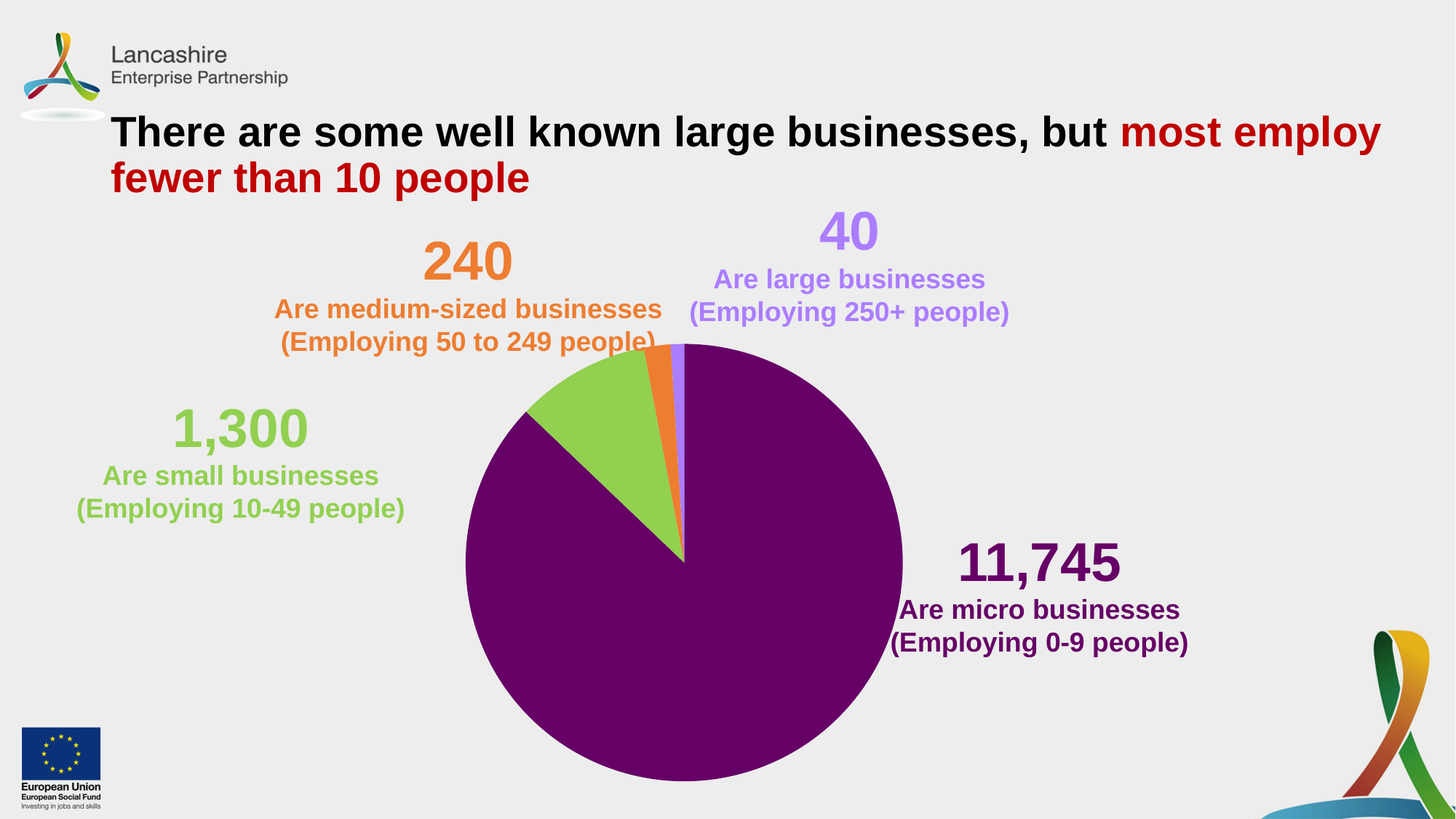
What is the difference between the number of micro businesses and the number of small businesses? 10,445 What colour is the slice representing micro businesses? purple How many medium-sized businesses (employing 50 to 249 people) are there? 240 What type of chart is shown on the slide? pie chart Which business size category has the smallest slice of the pie? Large businesses (Employing 250+ people) Which is larger: the number of small businesses or the number of medium-sized businesses? small businesses How many large businesses (employing 250+ people) are there? 40 What is the difference between the number of medium-sized businesses and the number of large businesses? 200 Which business size category has the largest slice of the pie? Micro businesses (Employing 0-9 people) How many micro businesses (employing 0-9 people) are there? 11,745 How many slices does the pie chart have? 4 How many small businesses (employing 10-49 people) are there? 1,300